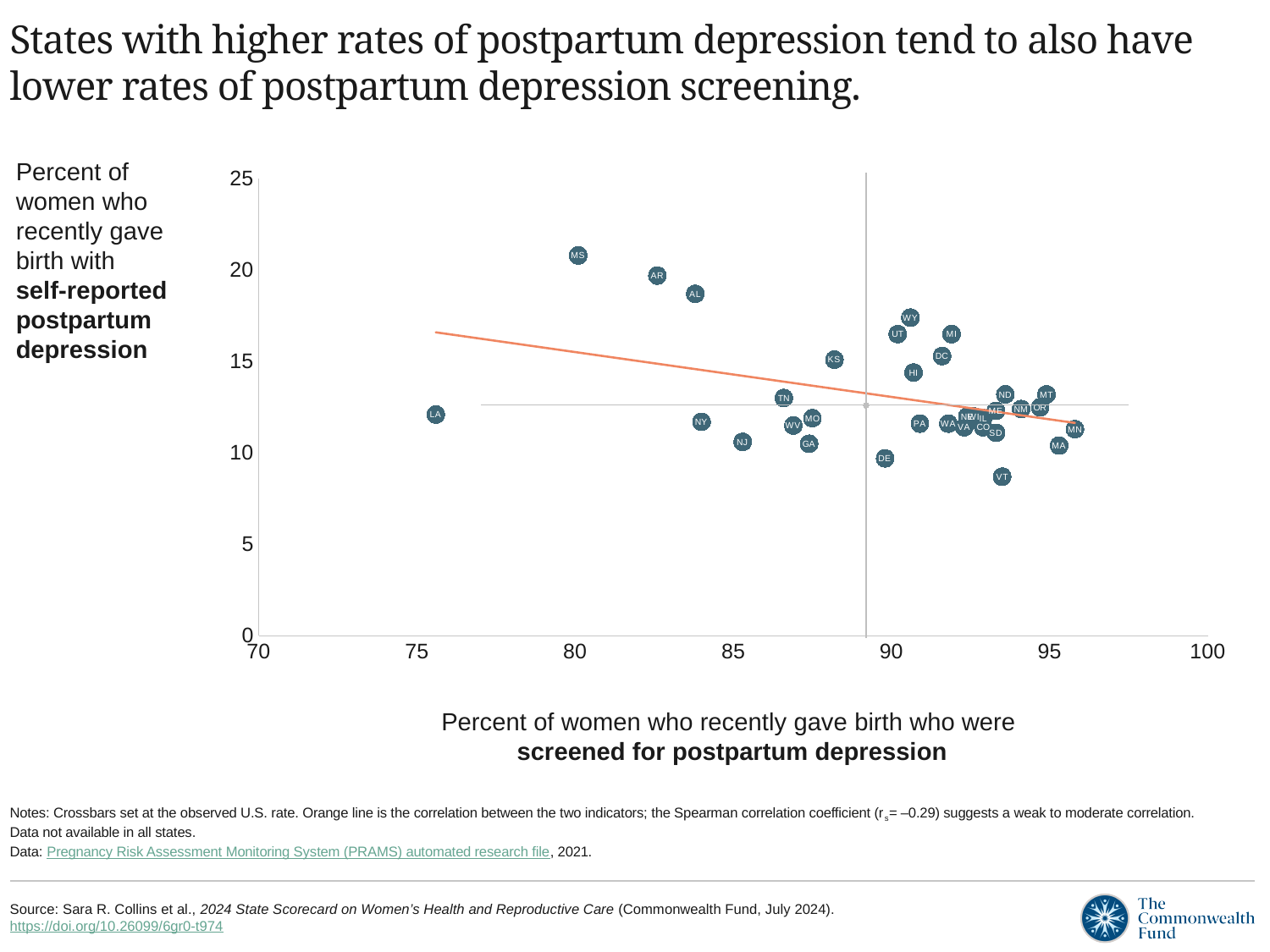
Is the self-reported postpartum depression rate for WY greater or less than 15? greater Does the orange correlation line rise or fall as the screening rate increases along the x axis? Falls Which state has the highest percent of women with self-reported postpartum depression? MS Is the screening rate for LA greater or less than 80? less What kind of chart is shown on the slide? Scatter plot Is the screening rate for KS greater or less than 90? less What Spearman correlation coefficient is reported in the notes? –0.29 Which state has a higher self-reported postpartum depression rate, AL or NY? AL Which state has the lowest percent of women screened for postpartum depression? LA Which state has the lowest percent of women with self-reported postpartum depression? VT